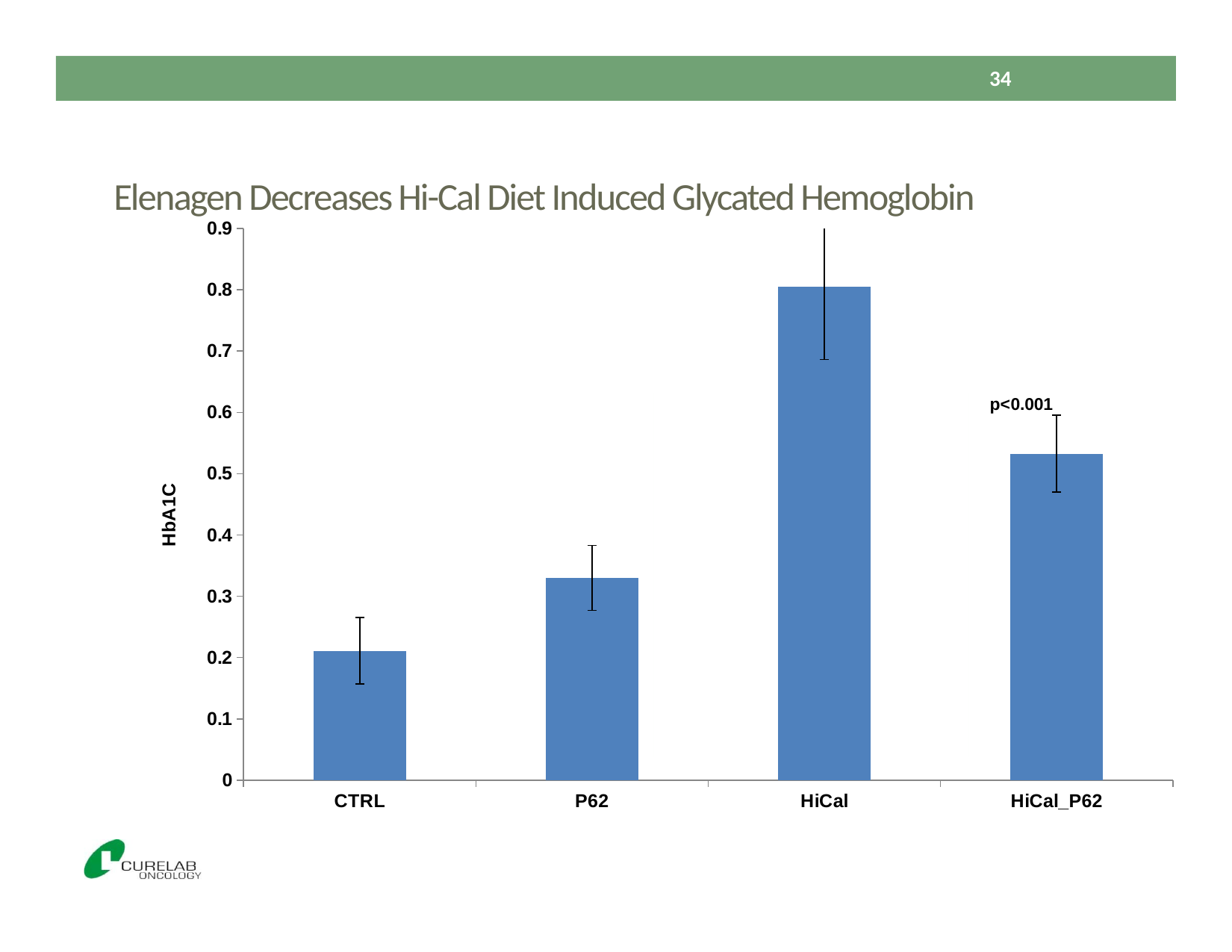
Which has a larger HbA1C value, HiCal or HiCal_P62? HiCal Is the value for HiCal greater or less than 0.7? greater Which category has the lowest HbA1C value? CTRL Which has a larger HbA1C value, P62 or CTRL? P62 What is the label on the y axis of the chart? HbA1C What kind of chart is shown on the slide? bar chart What p-value annotation is shown above the HiCal_P62 bar? p<0.001 How many categories are plotted on the x axis? 4 Is the value for HiCal_P62 greater or less than 0.6? less Which category has the highest HbA1C value? HiCal Is the value for CTRL greater or less than 0.3? less